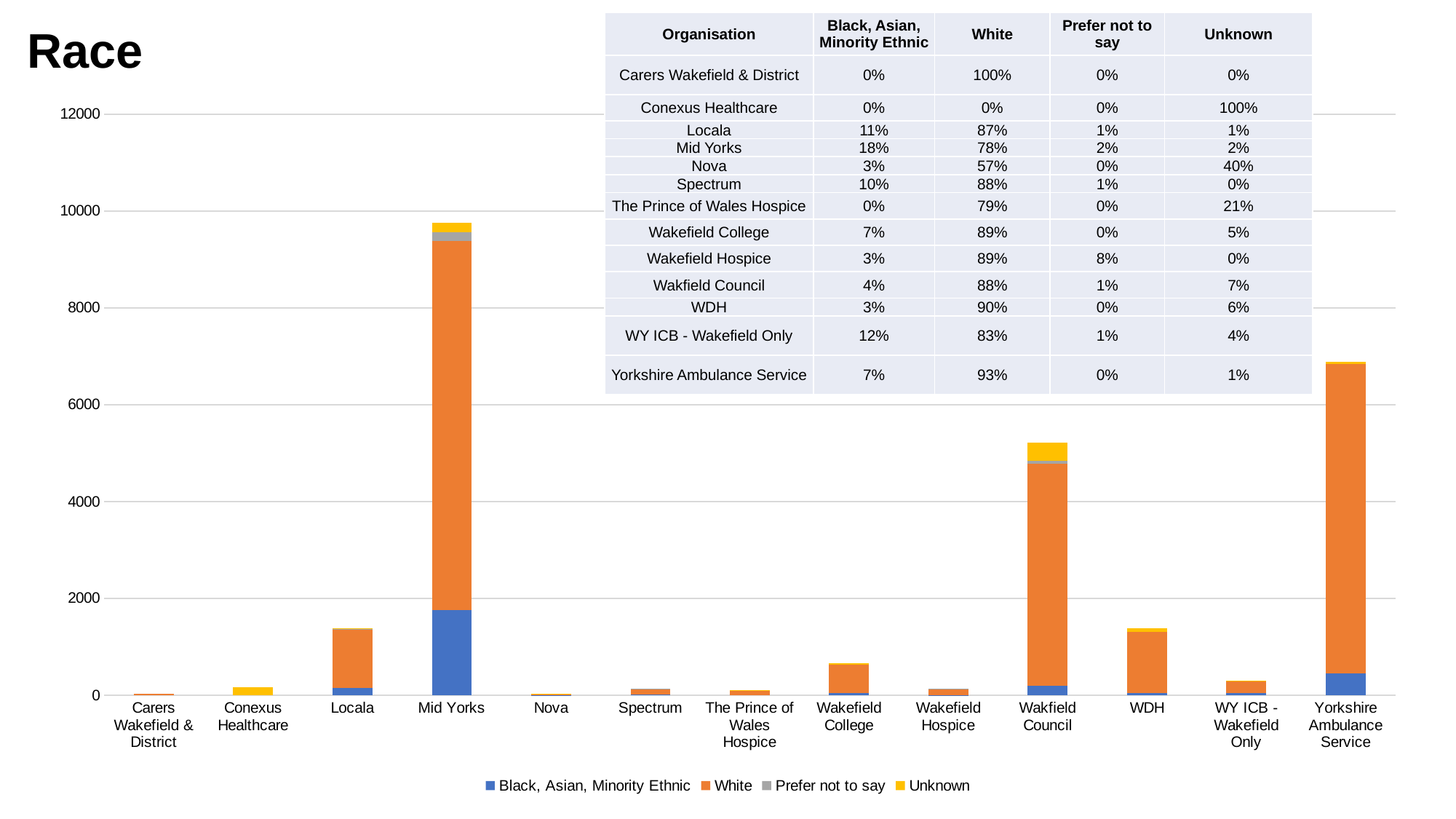
Which has the taller bar, Yorkshire Ambulance Service or WDH? Yorkshire Ambulance Service Is the total bar for Yorkshire Ambulance Service greater or less than 6000? greater How many series does the chart legend list? 4 Which organisation has the tallest bar in the chart? Mid Yorks Is the total bar for Wakfield Council greater or less than 4000? greater How many organisations are shown along the x axis of the chart? 13 Is the total bar for Wakefield College greater or less than 1000? less Which has the taller bar, Mid Yorks or Wakfield Council? Mid Yorks What is the title of the slide containing the chart? Race What kind of chart is shown on the slide? Stacked bar chart